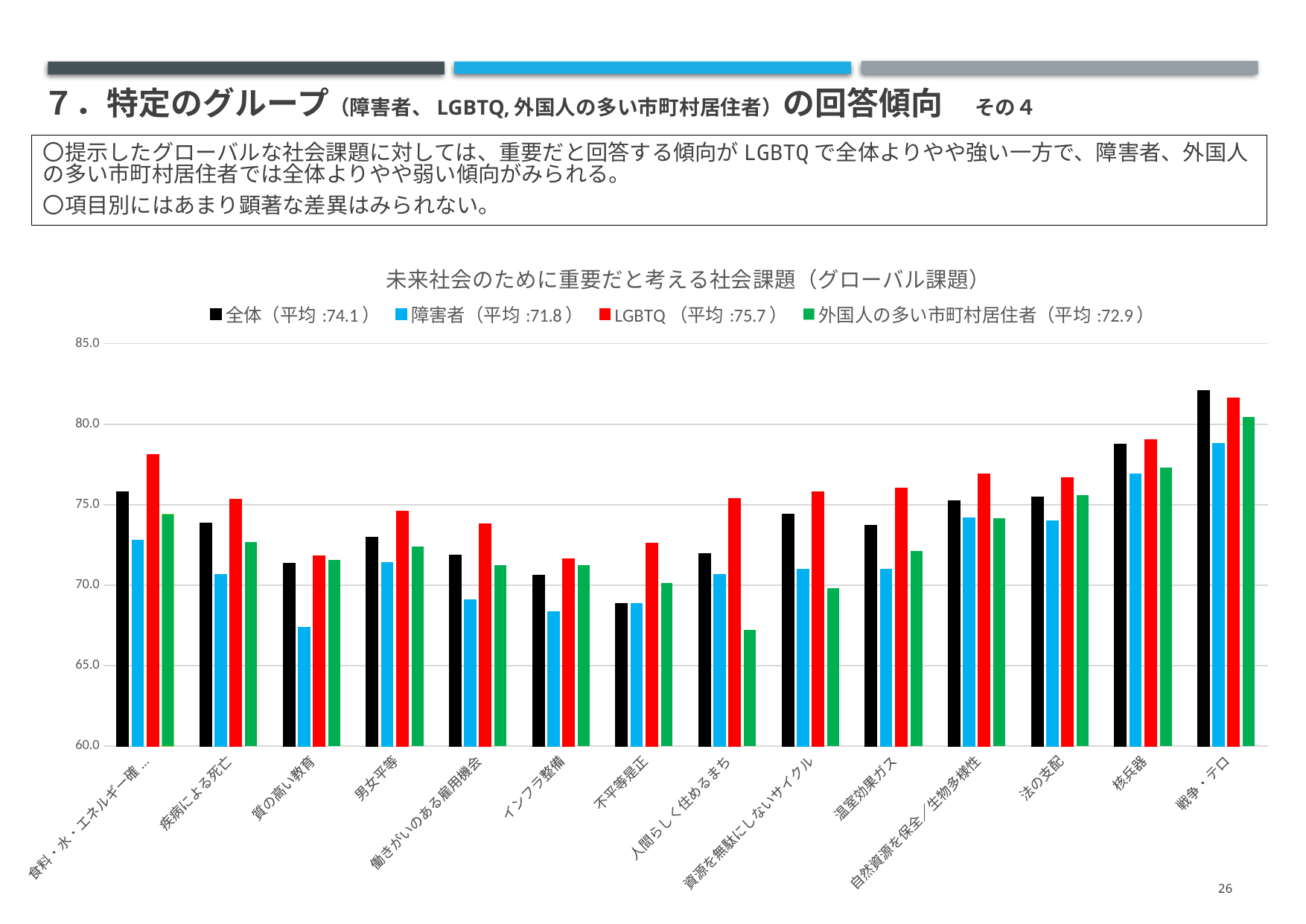
Is the 全体 value for 戦争・テロ greater or less than 80.0? greater How many series does the legend list? 4 According to the legend, what is the average (平均) for the LGBTQ series? 75.7 For 食料・水・エネルギー確…, which is larger: the LGBTQ value or the 障害者 value? LGBTQ Which series has the highest average shown in the legend? LGBTQ What is the difference between the legend averages of LGBTQ (75.7) and 障害者 (71.8)? 3.9 What is the title of the chart? 未来社会のために重要だと考える社会課題（グローバル課題） For the 全体 series, which category has the lowest value? 不平等是正 For the 全体 series, which category has the highest value? 戦争・テロ What kind of chart is shown on the slide? bar chart According to the legend, what is the average (平均) for the 障害者 series? 71.8 How many categories are shown along the x axis? 14